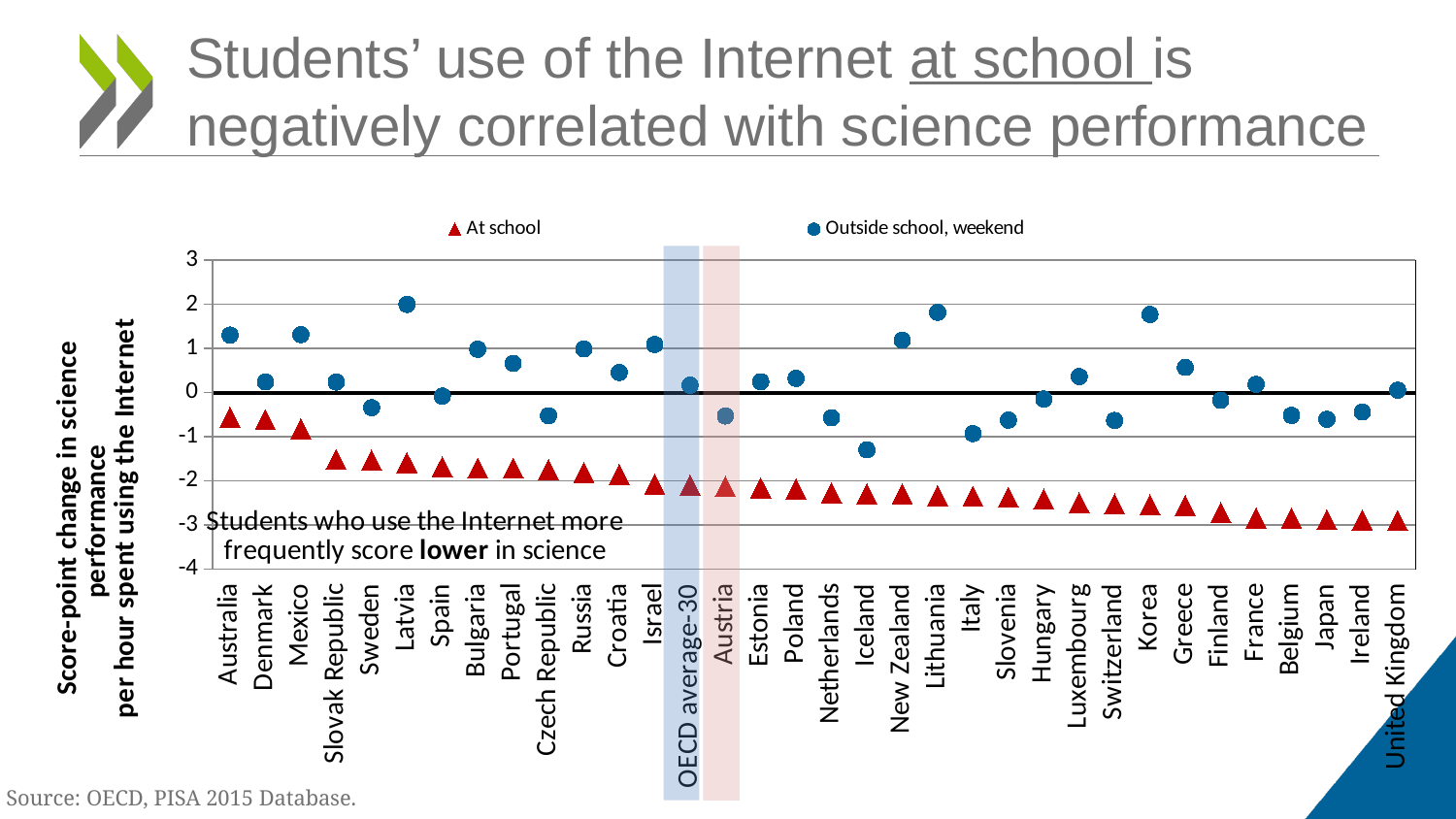
What are the two series shown in the chart legend? At school; Outside school, weekend Do the 'At school' values generally rise or fall from left to right along the x axis? Fall Is the 'Outside school, weekend' value for Iceland greater or less than -1? less What kind of chart is shown on the slide? Scatter chart (marker chart) How many countries/categories are plotted along the x axis of the chart? 34 Which has the higher 'Outside school, weekend' value, Mexico or Sweden? Mexico Which two categories on the x axis are highlighted with shaded bands? OECD average-30 and Austria Is the 'Outside school, weekend' value for Latvia greater or less than 1? greater Is the 'At school' value for Australia greater or less than -1? greater Which has the higher 'At school' value, Australia or the Slovak Republic? Australia How many series does the chart legend list? 2